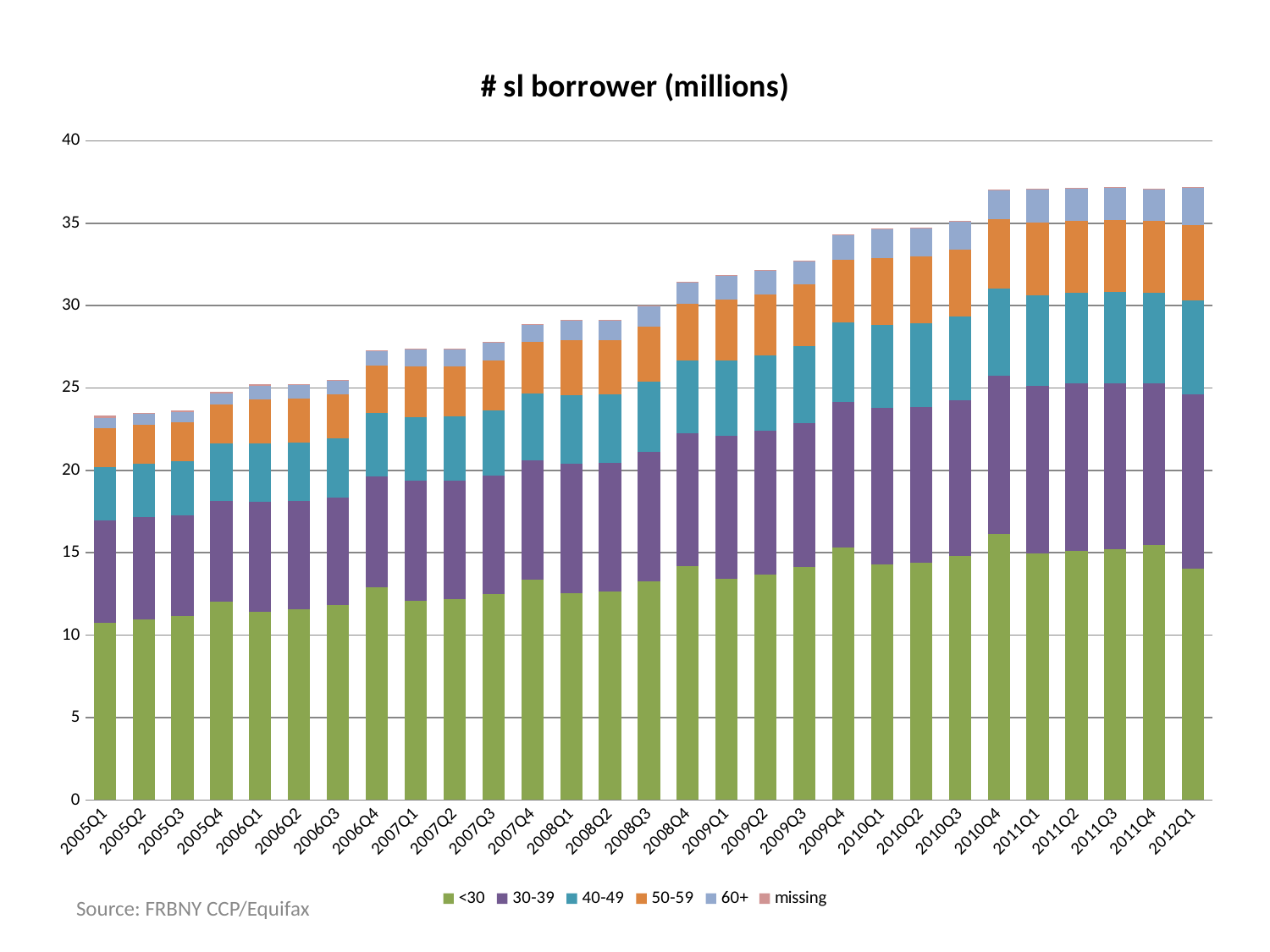
How many series does the legend list? 6 What is the title of the chart? # sl borrower (millions) Which quarter has the lowest total number of borrowers? 2005Q1 Is the total bar height for 2005Q1 greater or less than 25? less What kind of chart is shown on the slide? Stacked bar chart How many quarters are shown along the x axis? 29 Is the total bar height for 2007Q1 greater or less than 30? less Is the total bar height for 2008Q4 greater or less than 30? greater Which has the larger total bar, 2005Q1 or 2012Q1? 2012Q1 Do the total bar heights generally rise or fall from 2005Q1 to 2012Q1? Rise Which series is listed first in the legend? <30